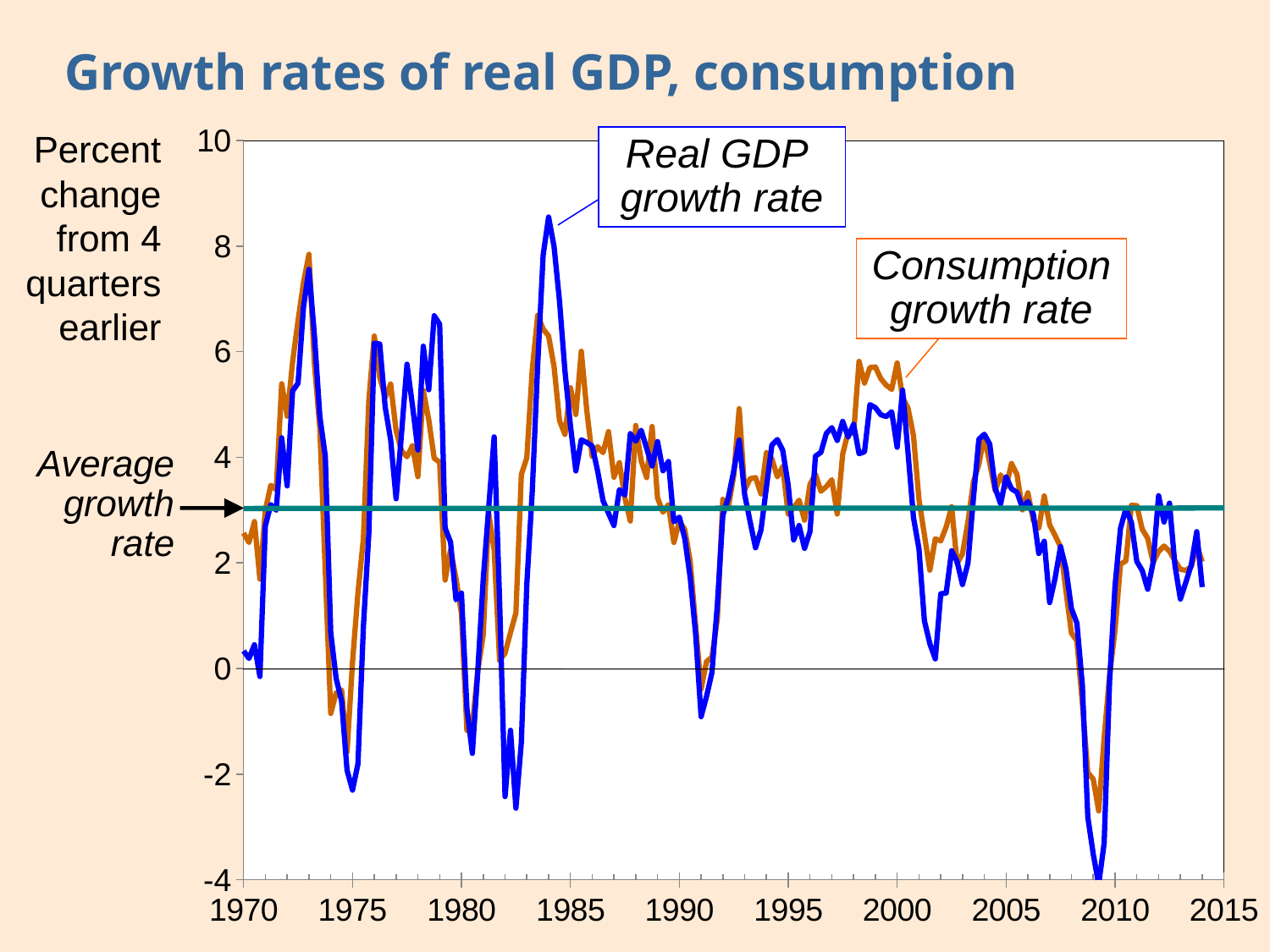
Is the Real GDP growth rate at its 1984 peak greater or less than 8? greater How many growth-rate series are plotted as lines in the chart (excluding the average line)? 2 Around which year does the Real GDP growth rate reach its lowest value? 2009 At the 2009 trough, which series falls lower: Real GDP growth rate or Consumption growth rate? Real GDP growth rate Is the Consumption growth rate at its 2009 low greater or less than 0? less Is the average growth rate line greater or less than 2? greater What is the title of the chart? Growth rates of real GDP, consumption What does the vertical axis measure, according to the label on the left of the chart? Percent change from 4 quarters earlier Around which year does the Real GDP growth rate reach its highest value? 1984 What kind of chart is shown on the slide? Line chart At the 1984 peak, which series is higher: Real GDP growth rate or Consumption growth rate? Real GDP growth rate